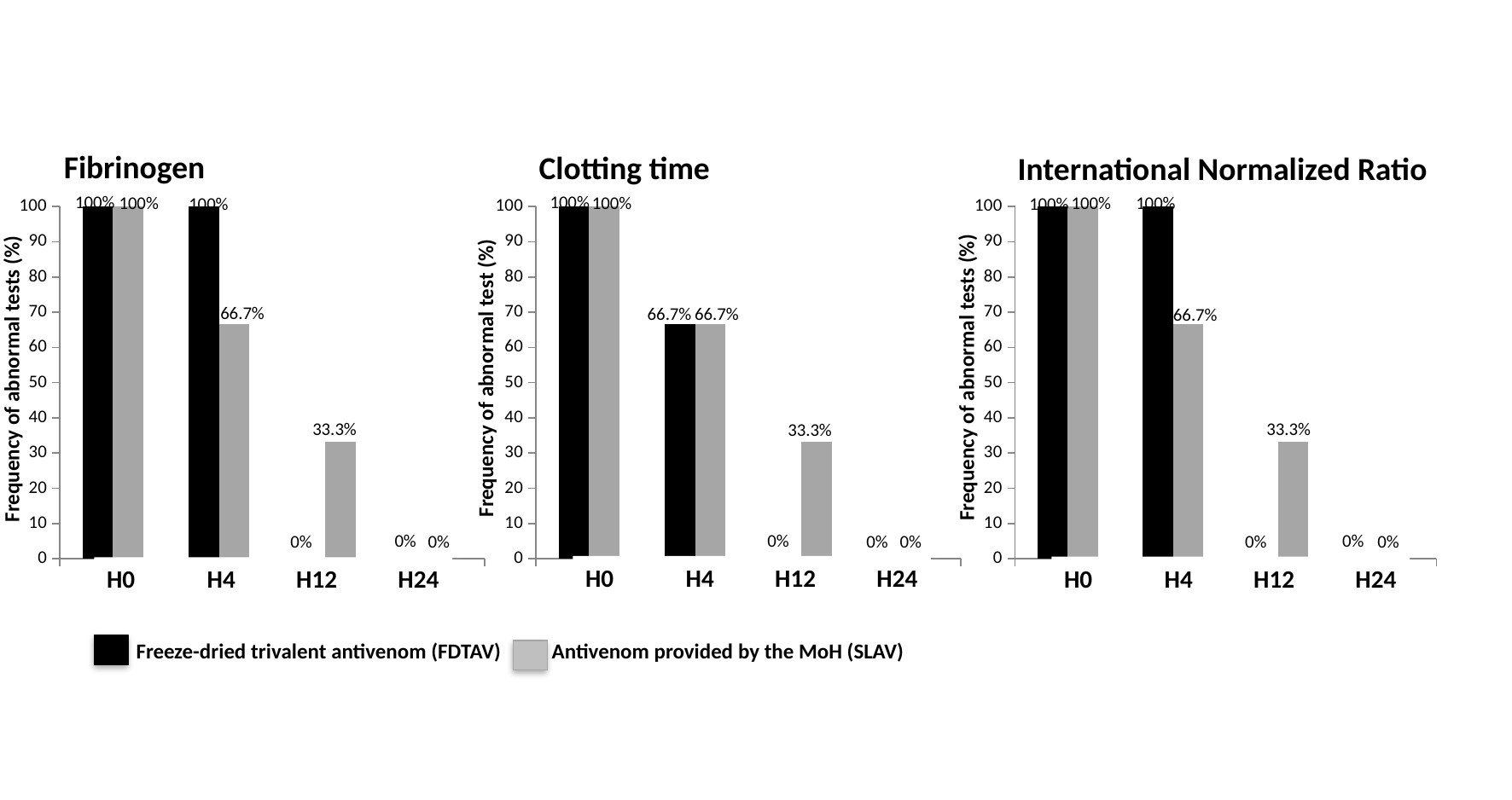
In the Fibrinogen chart, what is the value for FDTAV at H12? 0% In the International Normalized Ratio chart, which is larger at H4, the FDTAV value or the SLAV value? FDTAV In the International Normalized Ratio chart, what is the value for SLAV at H12? 33.3% How many series does the legend list? 2 In the Clotting time chart, what is the value for FDTAV at H4? 66.7% In the International Normalized Ratio chart, do the SLAV values rise or fall from H0 to H24? fall In the Clotting time chart, which is larger at H12, the FDTAV value or the SLAV value? SLAV In the Fibrinogen chart, what is the difference between the FDTAV and SLAV values at H4? 33.3% In the Fibrinogen chart, what is the value for SLAV at H4? 66.7% How many time-point categories are shown on the x axis of the Clotting time chart? 4 Which colour represents the Freeze-dried trivalent antivenom (FDTAV) in the legend? black What kind of chart is the Fibrinogen chart? bar chart